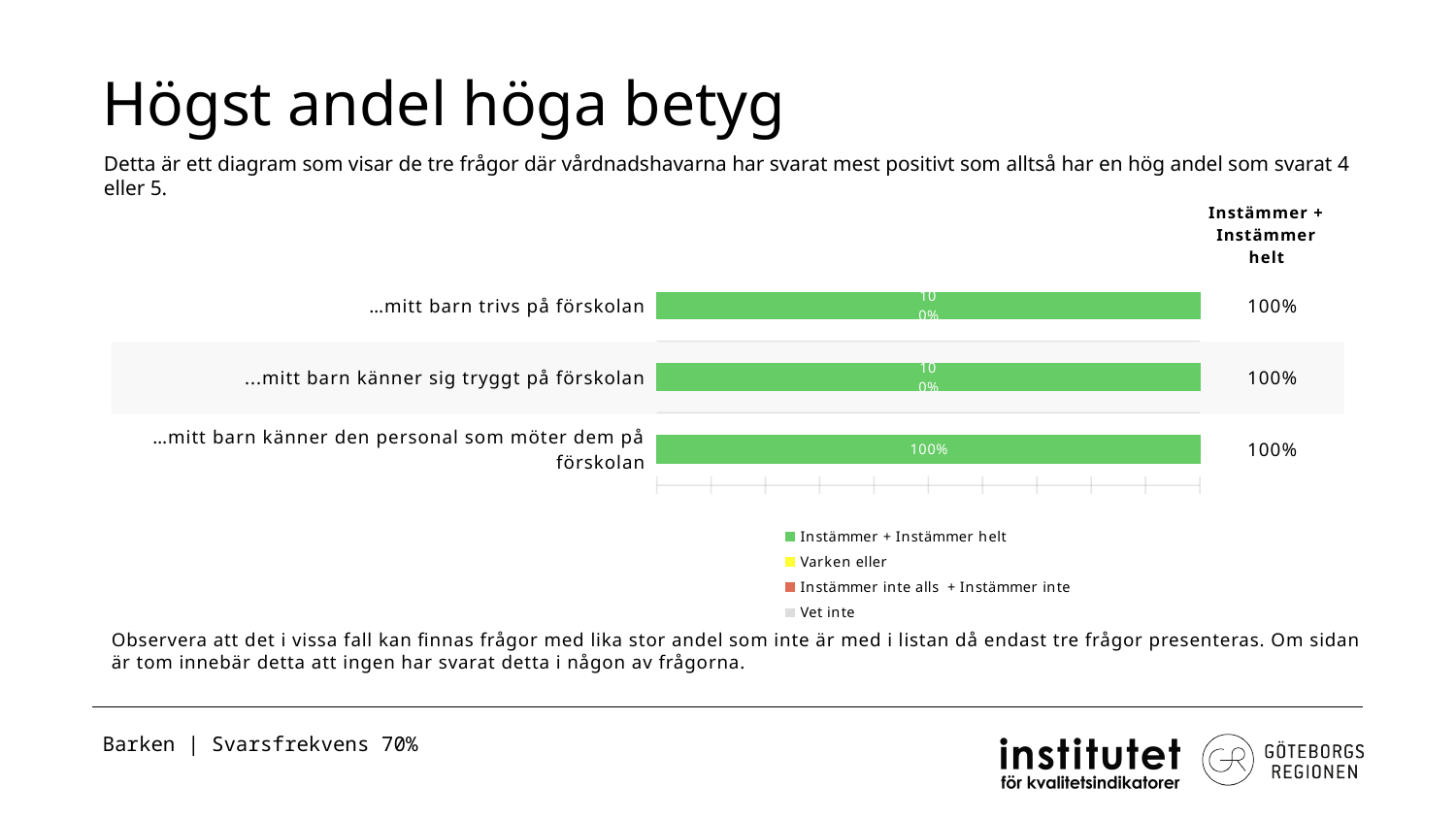
What is the difference between the 'Instämmer + Instämmer helt' values for '…mitt barn trivs på förskolan' and '…mitt barn känner den personal som möter dem på förskolan'? 0% Which colour represents 'Instämmer + Instämmer helt' in the legend? green What is the 'Instämmer + Instämmer helt' value for '…mitt barn trivs på förskolan'? 100% How many categories (questions) are plotted in the chart? 3 What is the title of the slide containing the chart? Högst andel höga betyg Do the 'Instämmer + Instämmer helt' values differ across the three categories? No, all are 100% How many series does the chart legend list? 4 What is the 'Instämmer + Instämmer helt' value for '...mitt barn känner sig tryggt på förskolan'? 100% What is the 'Instämmer + Instämmer helt' value for '…mitt barn känner den personal som möter dem på förskolan'? 100% Which legend entry is shown in yellow? Varken eller What kind of chart is shown on the slide? bar chart